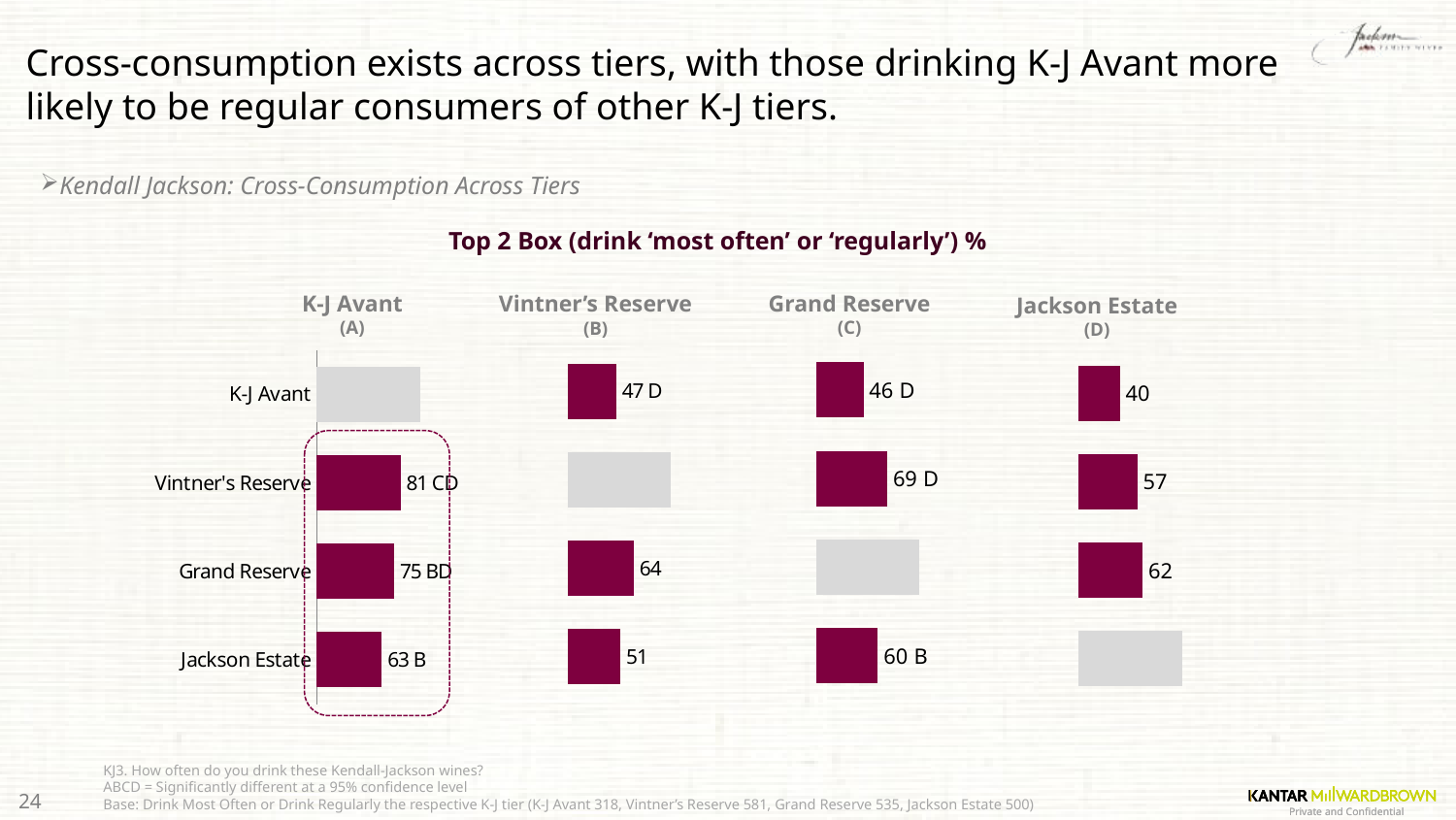
In the Vintner's Reserve (B) chart, which is larger: the value for Grand Reserve or the value for Jackson Estate? Grand Reserve In the Jackson Estate (D) chart, which category has the lowest value? K-J Avant In the Jackson Estate (D) chart, what is the value for K-J Avant? 40 How many bar charts are shown on the slide? 4 In the Grand Reserve (C) chart, what is the value for Jackson Estate? 60 In the Grand Reserve (C) chart, what is the difference between the values for Vintner's Reserve and K-J Avant? 23 What kind of chart is used to show the cross-consumption values? Bar chart In the K-J Avant (A) chart, what is the difference between the values for Vintner's Reserve and Jackson Estate? 18 In the K-J Avant (A) chart, what is the value for Vintner's Reserve? 81 In the Vintner's Reserve (B) chart, what is the value for Grand Reserve? 64 What is the title shown above the charts? Top 2 Box (drink 'most often' or 'regularly') %